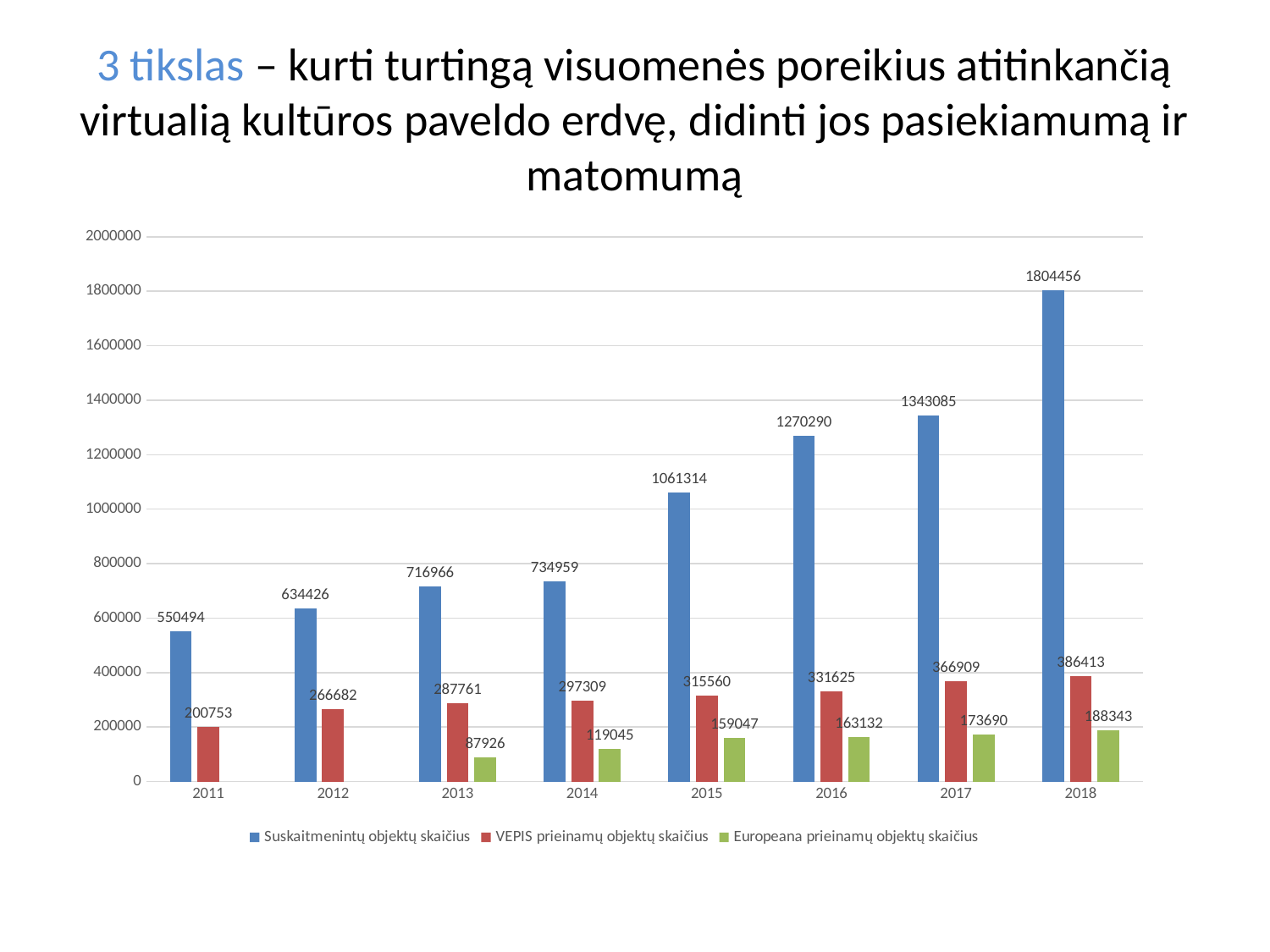
What is the value of VEPIS prieinamų objektų skaičius for 2014? 297309 What is the value of Suskaitmenintų objektų skaičius for 2018? 1804456 Which is larger in 2015: VEPIS prieinamų objektų skaičius or Europeana prieinamų objektų skaičius? VEPIS prieinamų objektų skaičius Which year has the lowest value for Europeana prieinamų objektų skaičius? 2013 How many series does the legend list? 3 What is the difference between Suskaitmenintų objektų skaičius and VEPIS prieinamų objektų skaičius in 2018? 1418043 What kind of chart is shown on the slide? bar chart What is the value of Europeana prieinamų objektų skaičius for 2013? 87926 Which year has the highest value for Suskaitmenintų objektų skaičius? 2018 Do the values of Suskaitmenintų objektų skaičius rise or fall from 2011 to 2018? rise Is the value of Suskaitmenintų objektų skaičius for 2016 greater or less than 1200000? greater How many years are shown on the x axis? 8